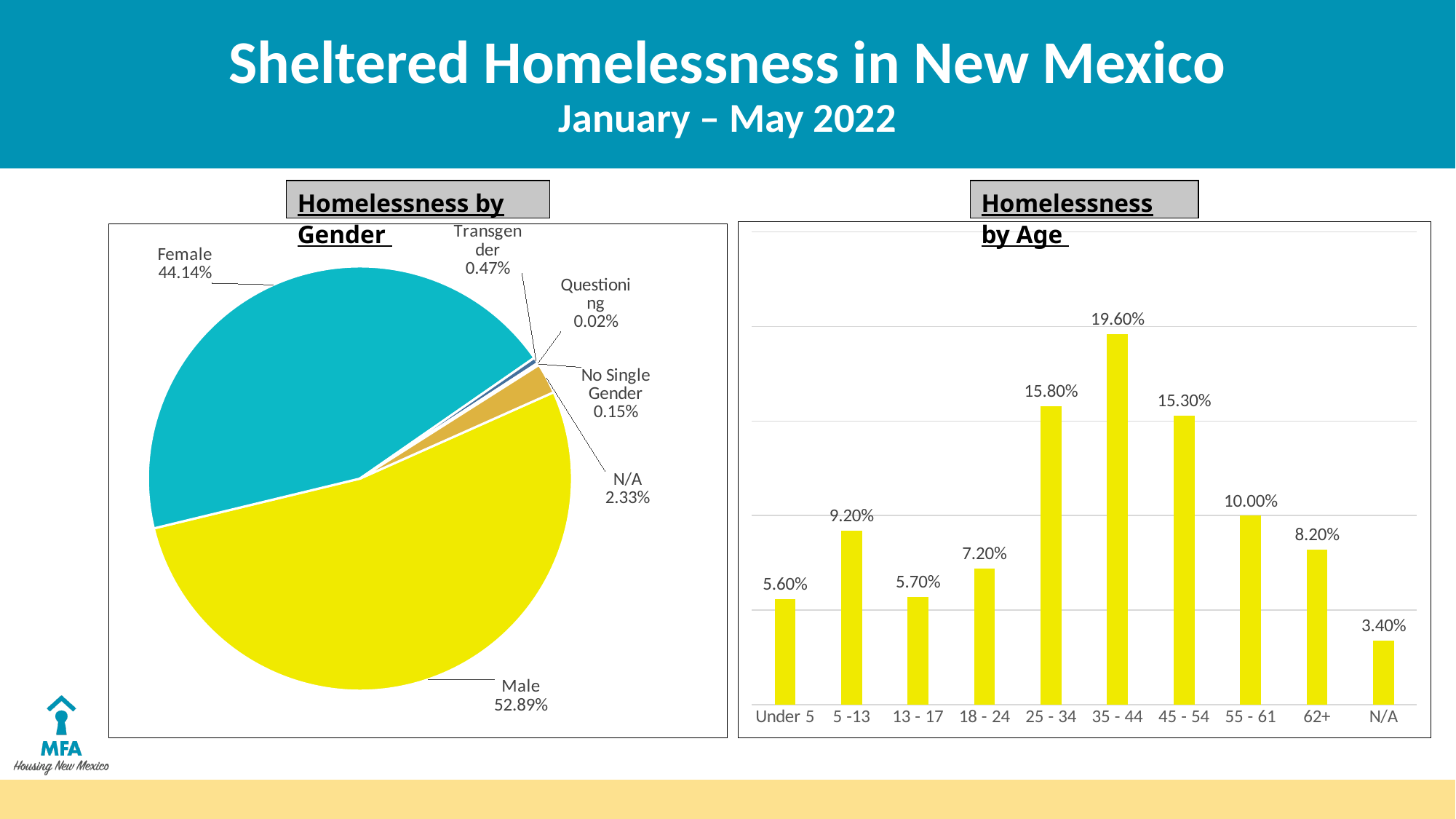
In the Homelessness by Gender chart, what share is N/A? 2.33% In the Homelessness by Age chart, which age group has the highest value? 35 - 44 In the Homelessness by Age chart, what is the difference between the values for 25 - 34 and 45 - 54? 0.50% In the Homelessness by Age chart, which age group has the lowest value? N/A In the Homelessness by Gender chart, what share is Female? 44.14% What kind of chart is the Homelessness by Gender chart? Pie chart In the Homelessness by Gender chart, how many categories are shown? 6 In the Homelessness by Gender chart, which category has the smallest share? Questioning In the Homelessness by Age chart, what is the value for 35 - 44? 19.60% In the Homelessness by Age chart, how many age categories are shown? 10 In the Homelessness by Gender chart, what share is Male? 52.89% In the Homelessness by Age chart, what is the value for Under 5? 5.60%